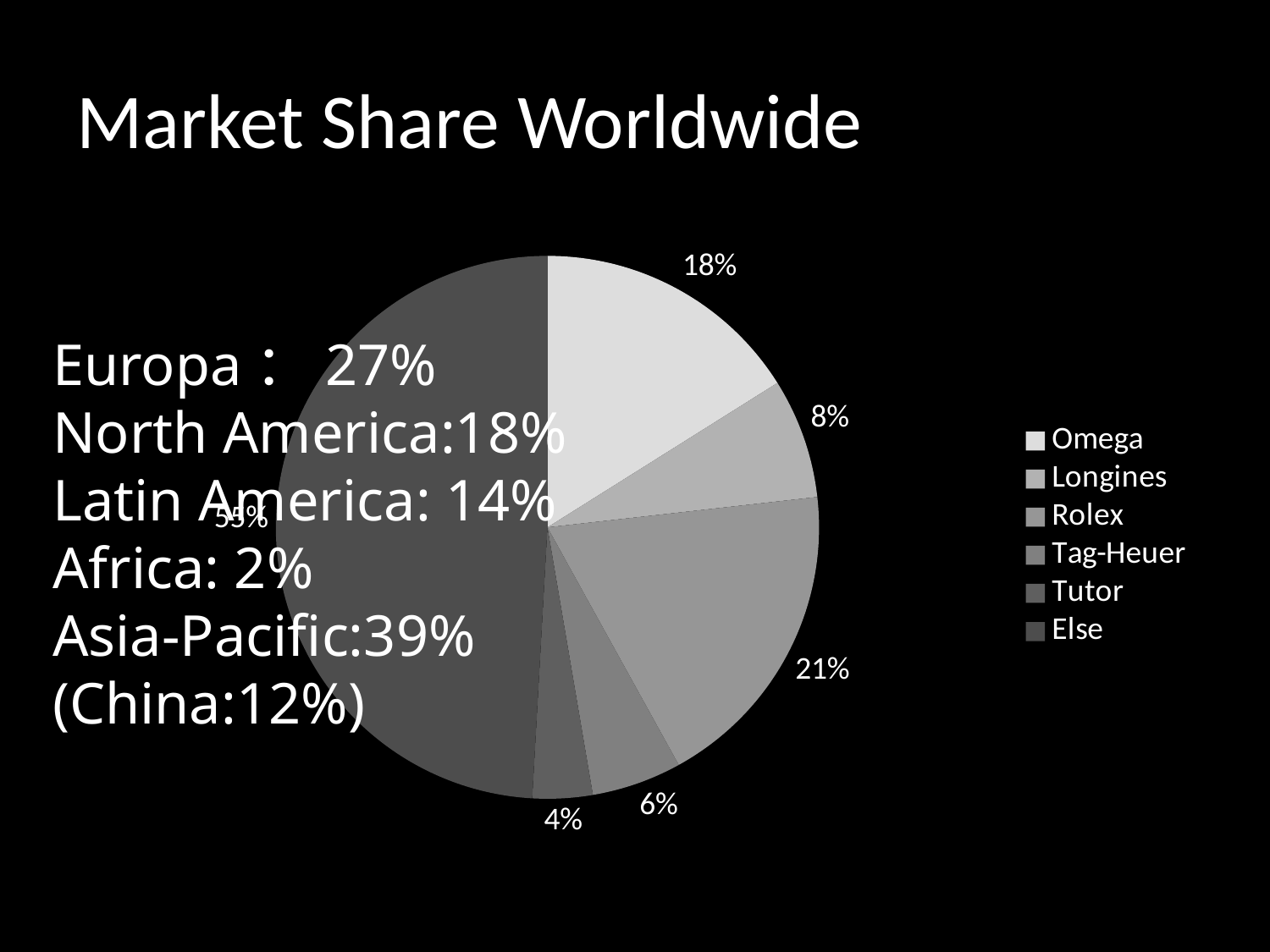
Which has a larger share in the pie chart, Rolex or Omega? Rolex What is the difference between the shares of Rolex and Omega? 3% What is the value shown for Longines in the pie chart? 8% Which slice of the pie chart is the largest? Else How many entries does the legend of the pie chart list? 6 What is the value shown for Tutor in the pie chart? 4% Which slice of the pie chart is the smallest? Tutor What kind of chart is shown on the slide? pie chart How many slices does the pie chart have? 6 What is the value shown for Rolex in the pie chart? 21% What is the value shown for Tag-Heuer in the pie chart? 6% What share of the pie does Omega hold? 18%